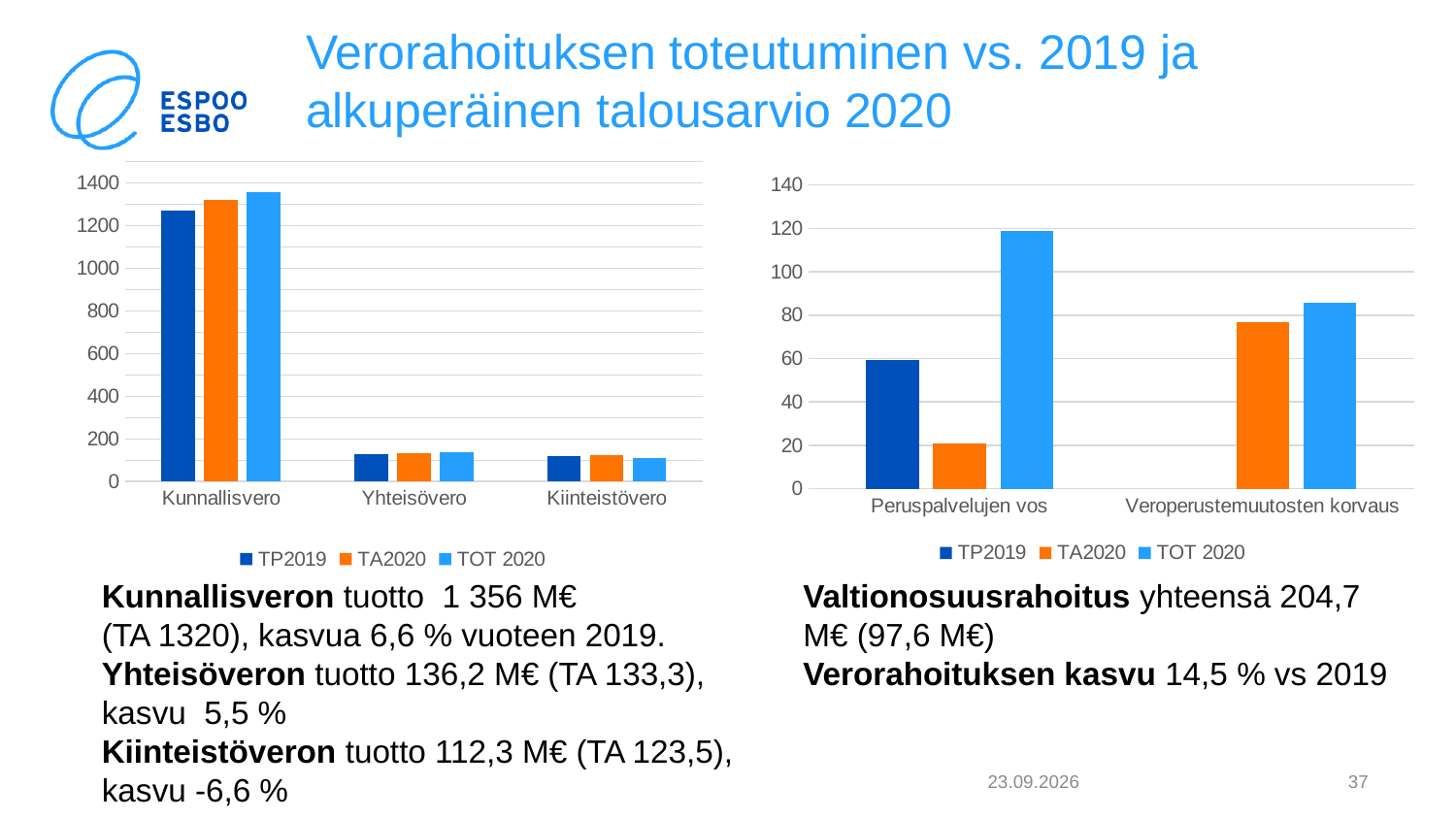
In the left chart, is the TOT 2020 value for Kiinteistövero greater or less than 200? less In the right chart, which series has the highest value for Peruspalvelujen vos? TOT 2020 In the left chart, is the TOT 2020 value for Kunnallisvero greater or less than 1200? greater In the right chart, is the TA2020 value for Peruspalvelujen vos greater or less than 40? less In the right chart, for Veroperustemuutosten korvaus, which is larger: TA2020 or TOT 2020? TOT 2020 In the left chart, which category has the highest values? Kunnallisvero In the left chart, how many series does the legend list? 3 What kind of chart is the left chart? bar chart In the left chart, which series is shown in orange? TA2020 In the left chart, how many categories are shown on the x axis? 3 In the right chart, how many categories are shown on the x axis? 2